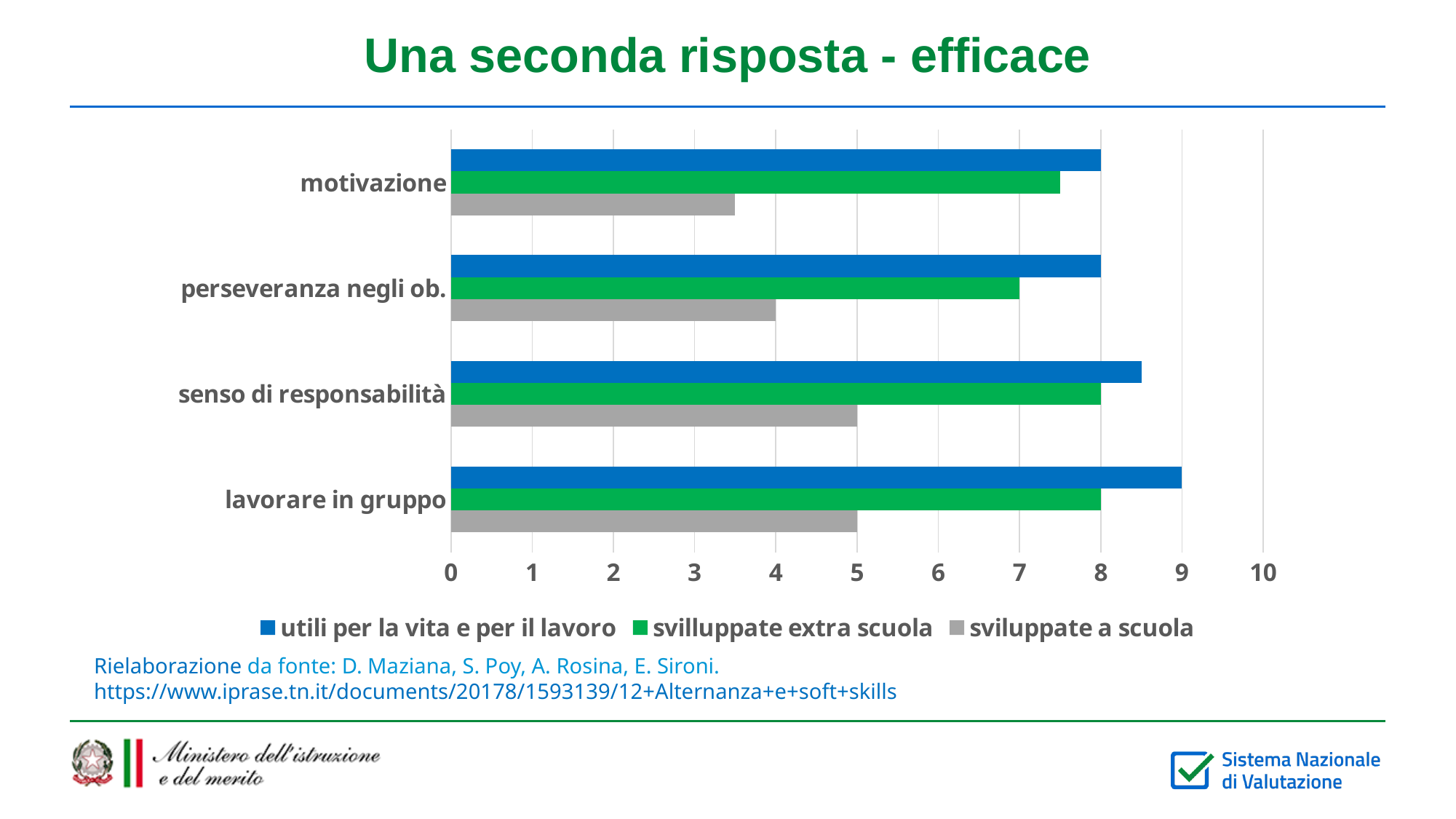
How many series does the legend list? 3 How many categories are shown on the chart? 4 What is the value of 'sviluppate a scuola' for 'senso di responsabilità'? 5 What is the difference between 'utili per la vita e per il lavoro' and 'sviluppate a scuola' for 'lavorare in gruppo'? 4 What is the value of 'sviluppate a scuola' for 'perseveranza negli ob.'? 4 Is the value of 'sviluppate a scuola' for 'motivazione' greater or less than 4? less What kind of chart is shown on the slide? bar chart Is the value of 'utili per la vita e per il lavoro' for 'senso di responsabilità' greater or less than 8? greater Which category has the lowest value for 'sviluppate a scuola'? motivazione What is the value of 'utili per la vita e per il lavoro' for 'lavorare in gruppo'? 9 Which category has the highest value for 'utili per la vita e per il lavoro'? lavorare in gruppo What is the value of 'sviluppate extra scuola' for 'perseveranza negli ob.'? 7